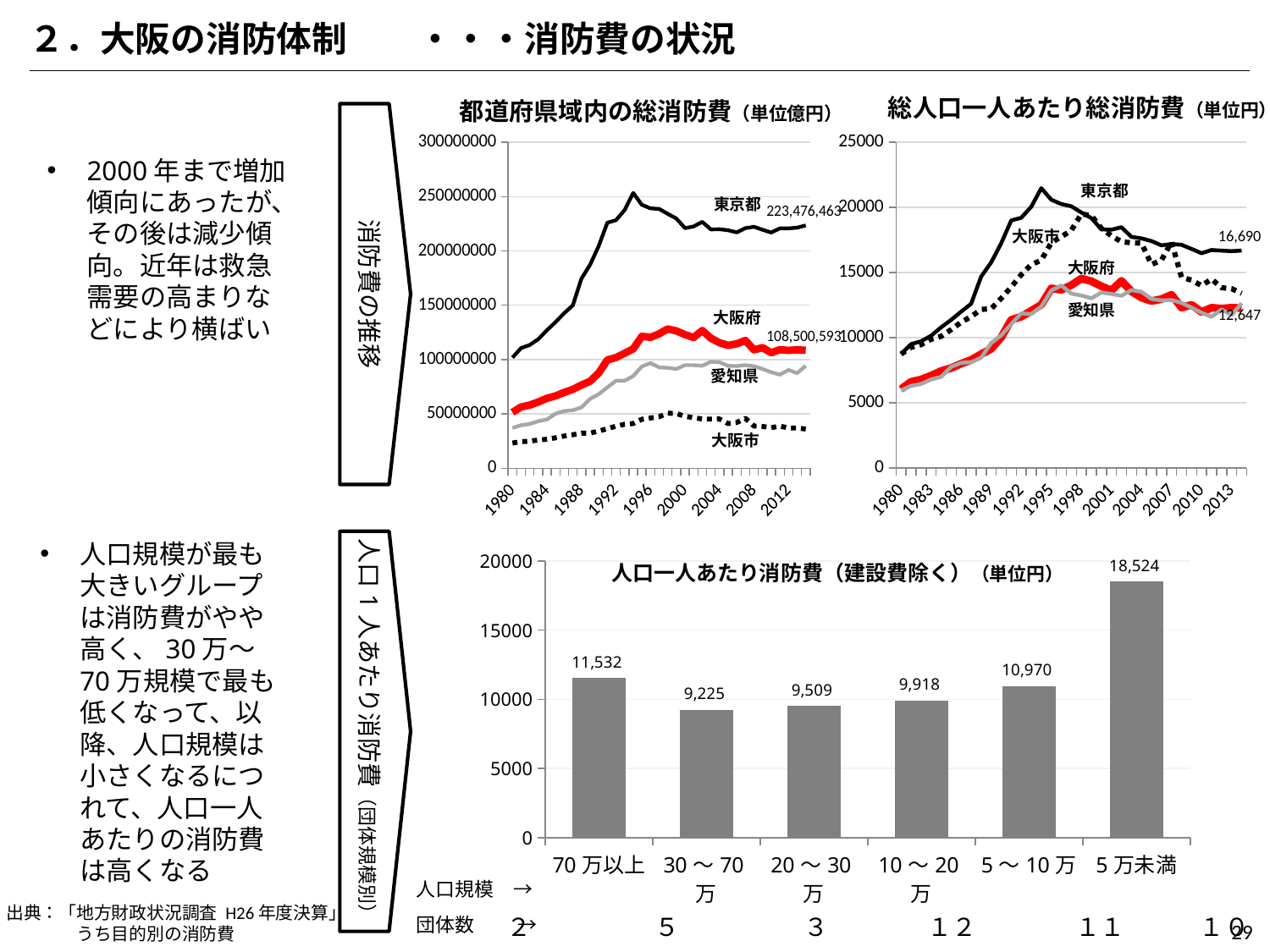
How many population-size categories are shown in the bar chart 人口一人あたり消防費（建設費除く）? 6 In the bar chart 人口一人あたり消防費（建設費除く）, what is the value for 5万未満? 18,524 In the bar chart 人口一人あたり消防費（建設費除く）, which population-size category has the lowest value? 30～70万 In the bar chart 人口一人あたり消防費（建設費除く）, what is the value for 30～70万? 9,225 In the line chart 都道府県域内の総消防費, what is the final labelled value for 東京都? 223,476,463 In the line chart 総人口一人あたり総消防費, what is the final labelled value for 東京都? 16,690 In the line chart 都道府県域内の総消防費, what is the final labelled value for 大阪府? 108,500,593 What kind of chart is 人口一人あたり消防費（建設費除く）? bar chart In the bar chart 人口一人あたり消防費（建設費除く）, which population-size category has the highest value? 5万未満 In the bar chart 人口一人あたり消防費（建設費除く）, which is larger, the value for 10～20万 or the value for 5～10万? 5～10万 How many series are plotted in the line chart 都道府県域内の総消防費? 4 In the bar chart 人口一人あたり消防費（建設費除く）, what is the difference between the values for 5万未満 and 70万以上? 6,992